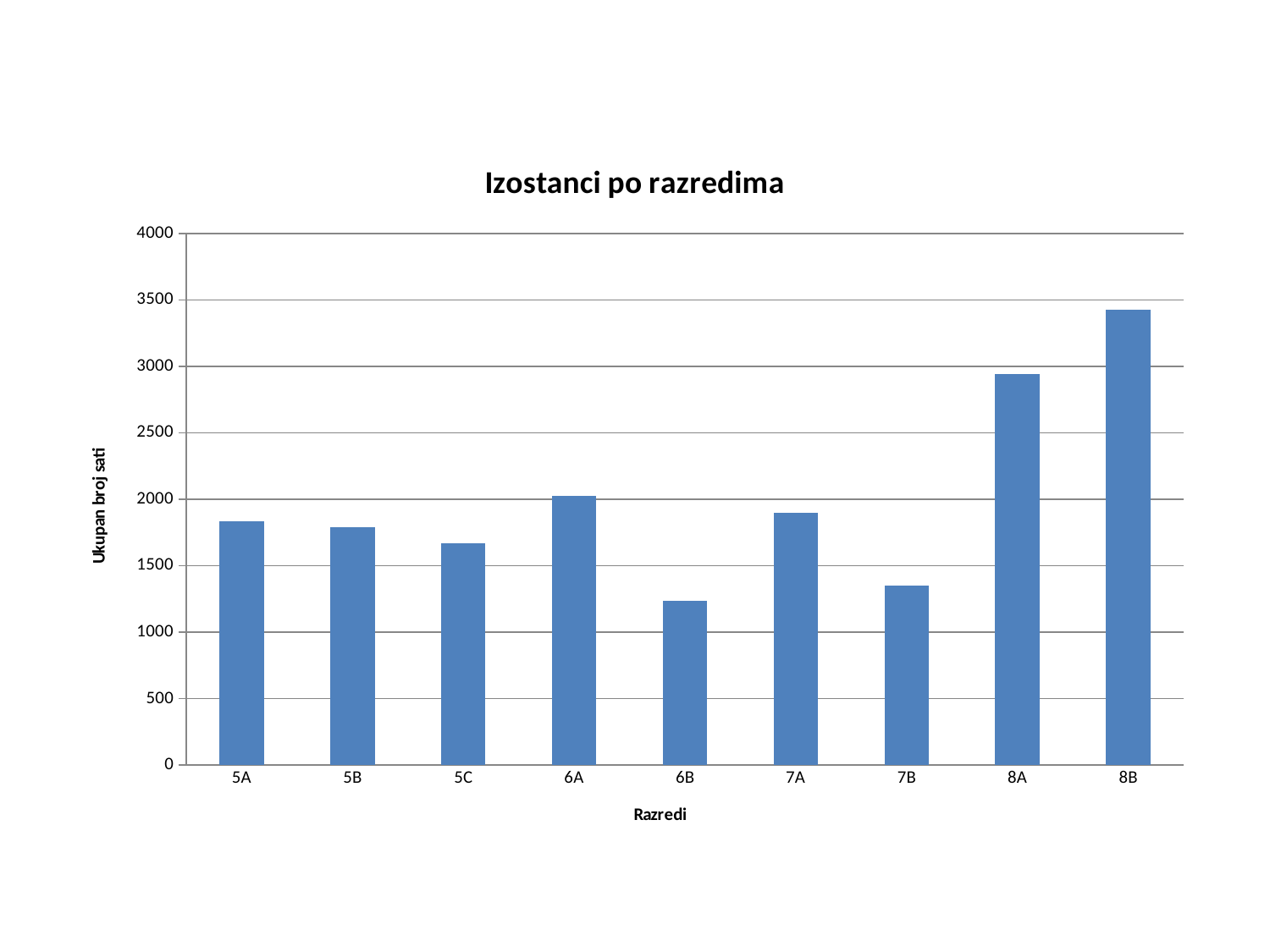
Which class has a larger value, 5C or 6B? 5C Which class has the highest total number of absence hours? 8B How many classes (categories) are shown on the x axis? 9 Which class has a larger value, 8A or 7A? 8A Is the value for 6B greater or less than 1500? less What is the title of the chart? Izostanci po razredima What kind of chart is shown on the slide? bar chart Which class has the lowest total number of absence hours? 6B Is the value for 7B greater or less than 1500? less Is the value for 8B greater or less than 3000? greater